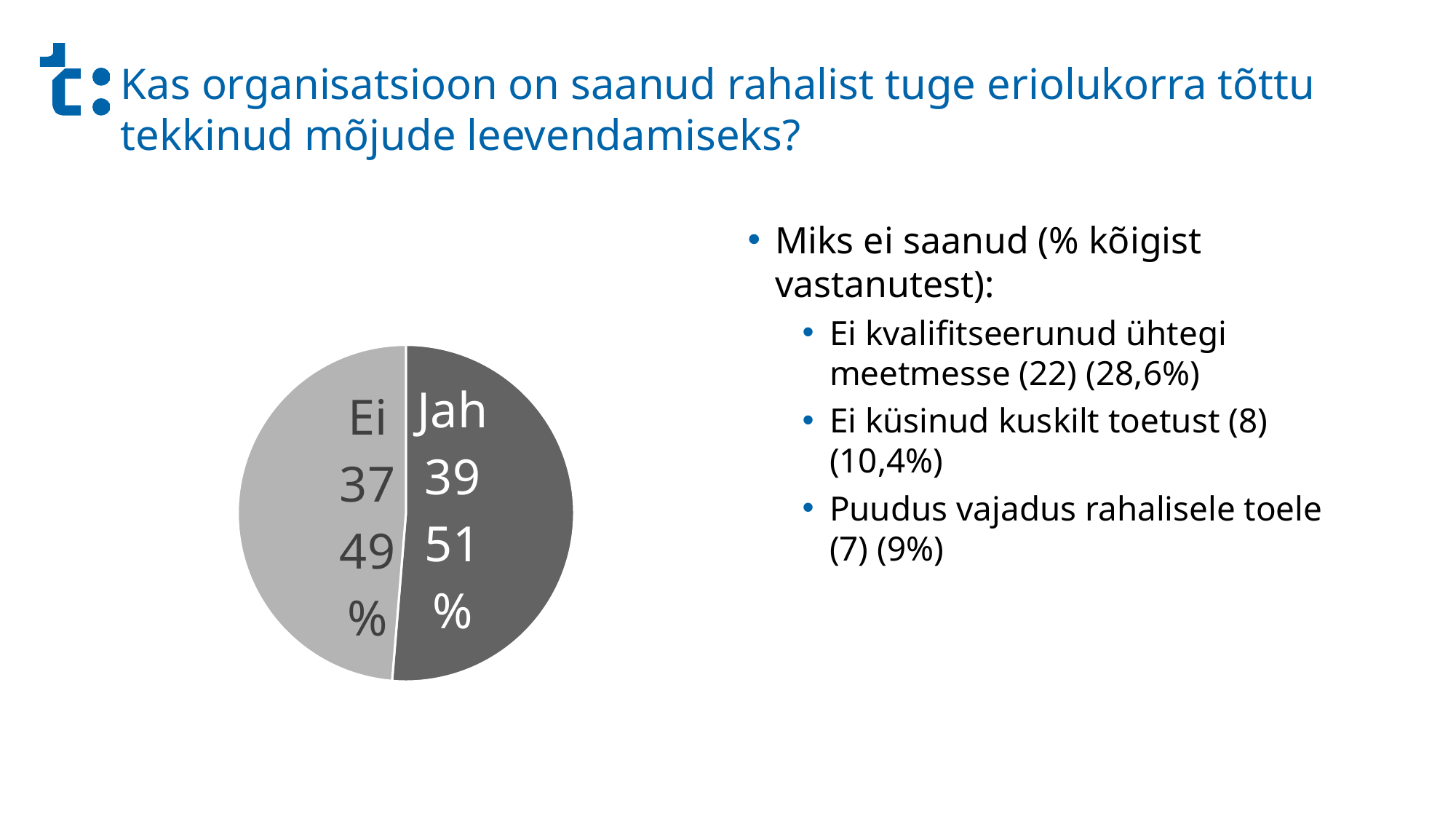
What percentage share does the "Ei" slice have in the pie chart? 49% What is the difference between the counts for "Jah" and "Ei" in the pie chart? 2 What is the count shown for the "Ei" slice of the pie chart? 37 Which slice of the pie chart is shown in the darker grey colour? Jah What is the total of the counts shown in the two slices of the pie chart? 76 What is the count shown for the "Jah" slice of the pie chart? 39 Which has a larger share in the pie chart, "Jah" or "Ei"? Jah How many slices does the pie chart have? 2 What percentage share does the "Jah" slice have in the pie chart? 51% Which slice of the pie chart is the largest? Jah Which slice of the pie chart is the smallest? Ei What kind of chart is shown on the slide? pie chart